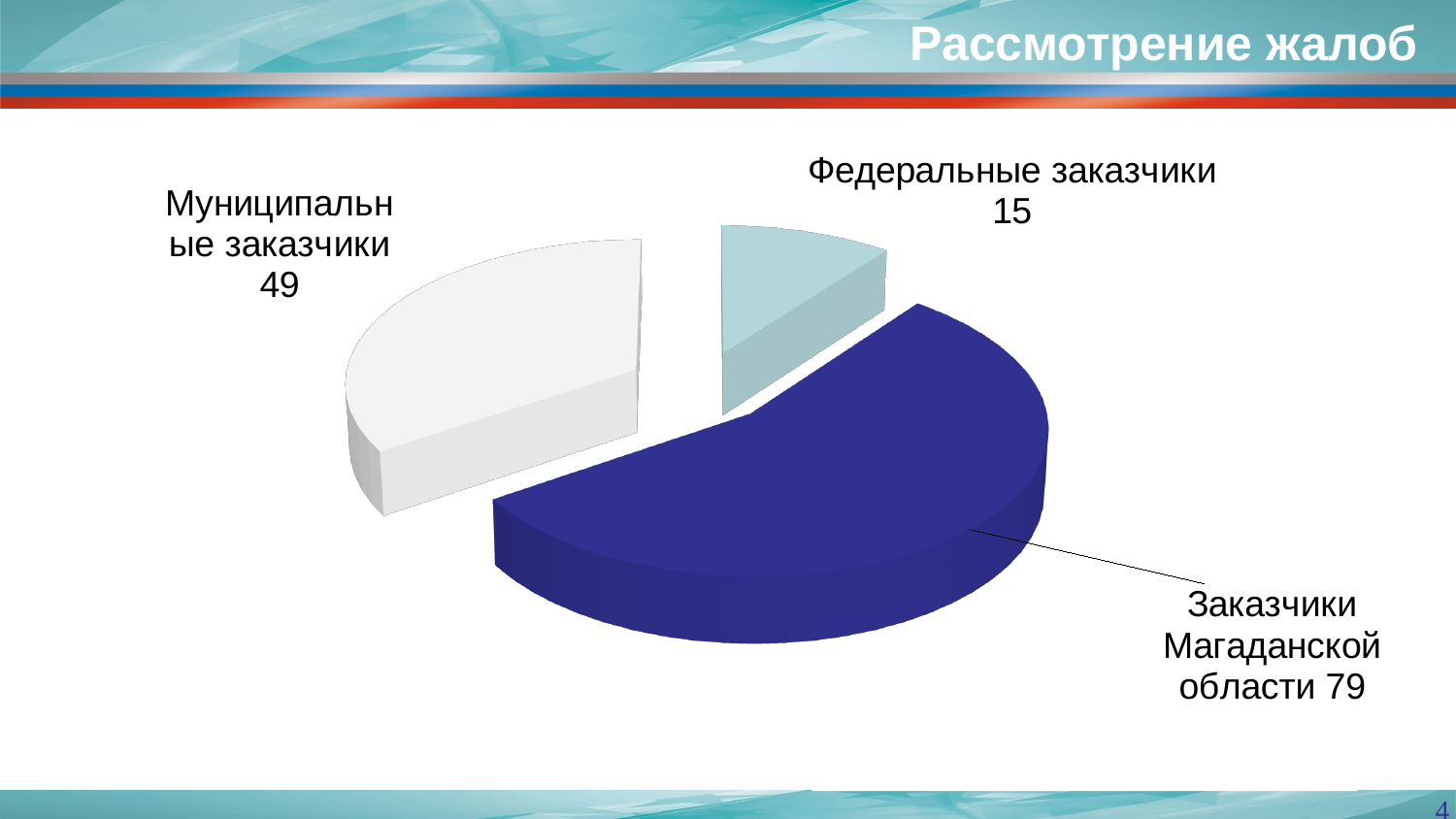
Which is larger, the value for Муниципальные заказчики or the value for Федеральные заказчики? Муниципальные заказчики How many categories are shown in the pie chart? 3 What is the difference between the values for Заказчики Магаданской области and Муниципальные заказчики? 30 What is the value for Федеральные заказчики? 15 What is the title of the slide? Рассмотрение жалоб What is the value for Муниципальные заказчики? 49 What is the value for Заказчики Магаданской области? 79 What kind of chart is shown on the slide? Pie chart What is the difference between the values for Муниципальные заказчики and Федеральные заказчики? 34 Which category has the largest slice of the pie? Заказчики Магаданской области What is the total of all the slices in the pie chart? 143 Which category has the smallest slice of the pie? Федеральные заказчики